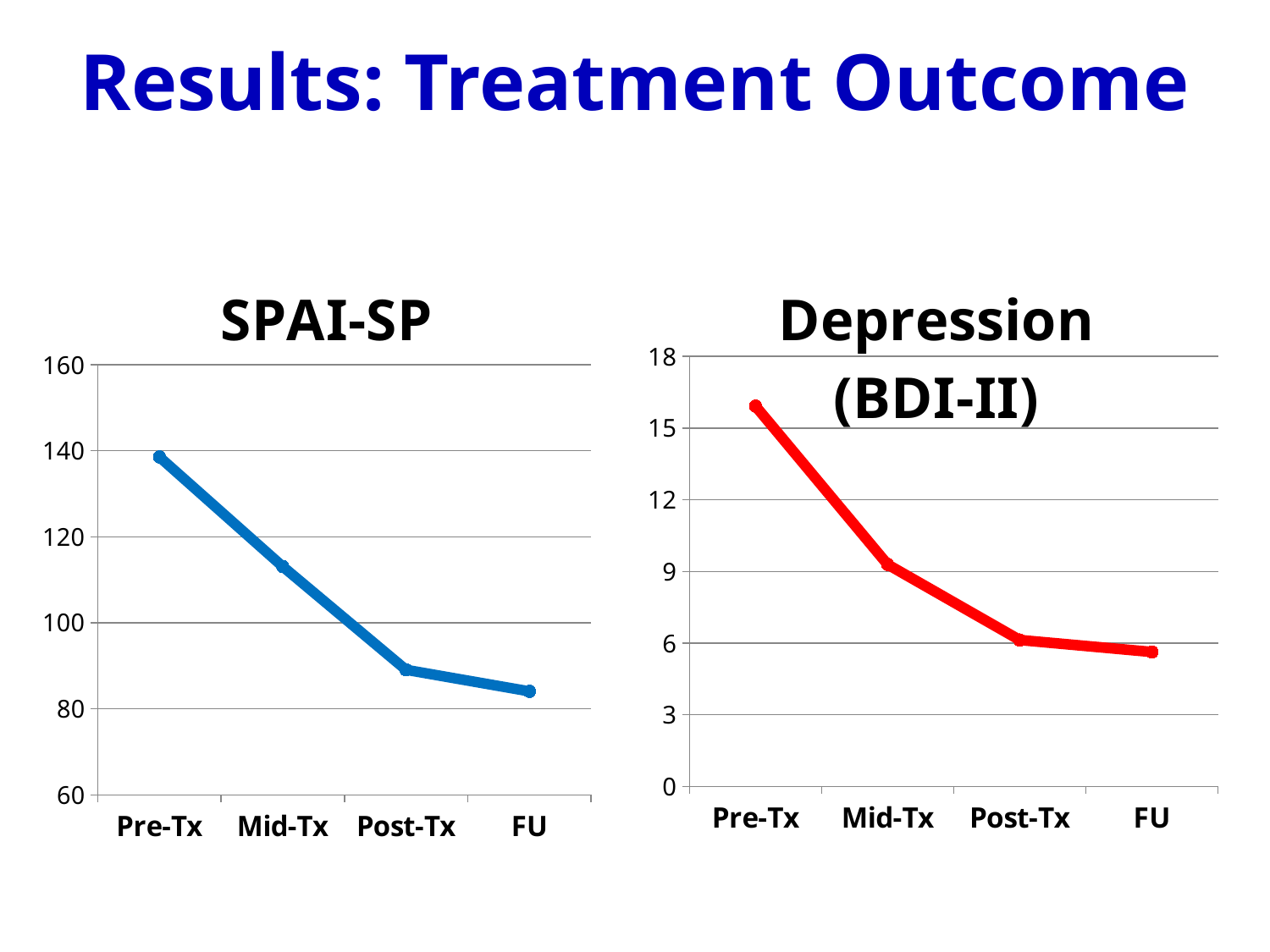
In the SPAI-SP chart, is the value for Pre-Tx greater or less than 120? greater What kind of chart is the SPAI-SP chart? line chart In the SPAI-SP chart, which time point has the lowest value? FU In the Depression (BDI-II) chart, which is larger, the value for Mid-Tx or the value for Post-Tx? Mid-Tx In the SPAI-SP chart, do the values rise or fall from Pre-Tx to FU? fall In the SPAI-SP chart, which time point has the highest value? Pre-Tx In the Depression (BDI-II) chart, is the value for Mid-Tx greater or less than 12? less In the SPAI-SP chart, how many time points are plotted along the x axis? 4 What colour is the line in the Depression (BDI-II) chart? red In the SPAI-SP chart, is the value for Post-Tx greater or less than 100? less In the Depression (BDI-II) chart, which time point has the highest value? Pre-Tx